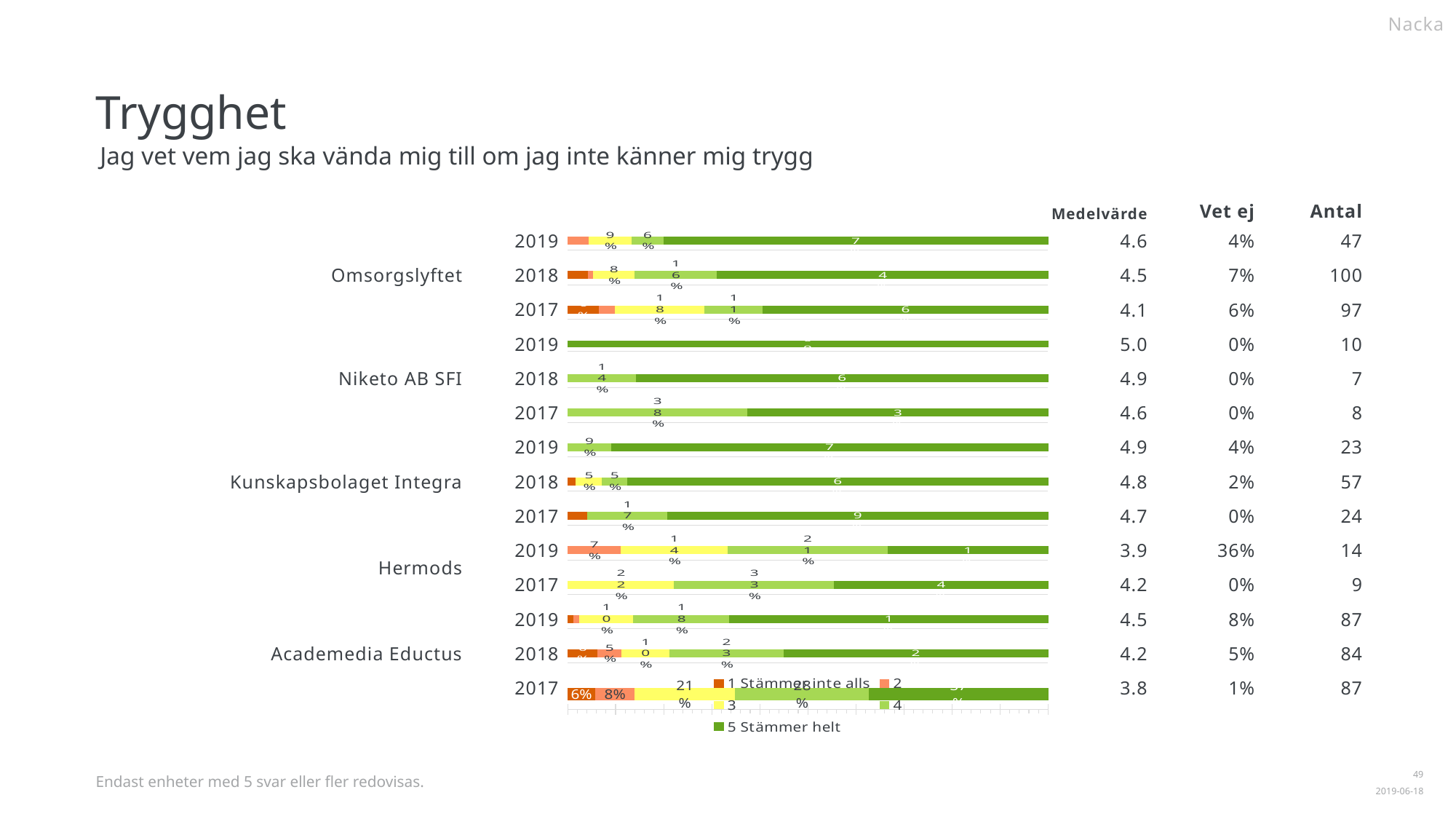
Is the '5 Stämmer helt' segment larger for Hermods 2019 or Hermods 2017? Hermods 2017 Which unit and year has the highest Medelvärde in the table next to the chart? Niketo AB SFI 2019 What percentage of the Hermods 2019 bar is the orange '2' segment? 7% What percentage of the Omsorgslyftet 2019 bar is the light green '4' segment? 6% What percentage of the Academedia Eductus 2017 bar is the '2' segment? 8% What kind of chart is shown on the slide? bar chart What percentage of the Academedia Eductus 2017 bar is the '1 Stämmer inte alls' segment? 6% How many bars (unit-year rows) are plotted in the chart? 14 What is the legend label for the dark green series? 5 Stämmer helt How many series does the chart legend list? 5 Which unit and year has the lowest Medelvärde in the table next to the chart? Academedia Eductus 2017